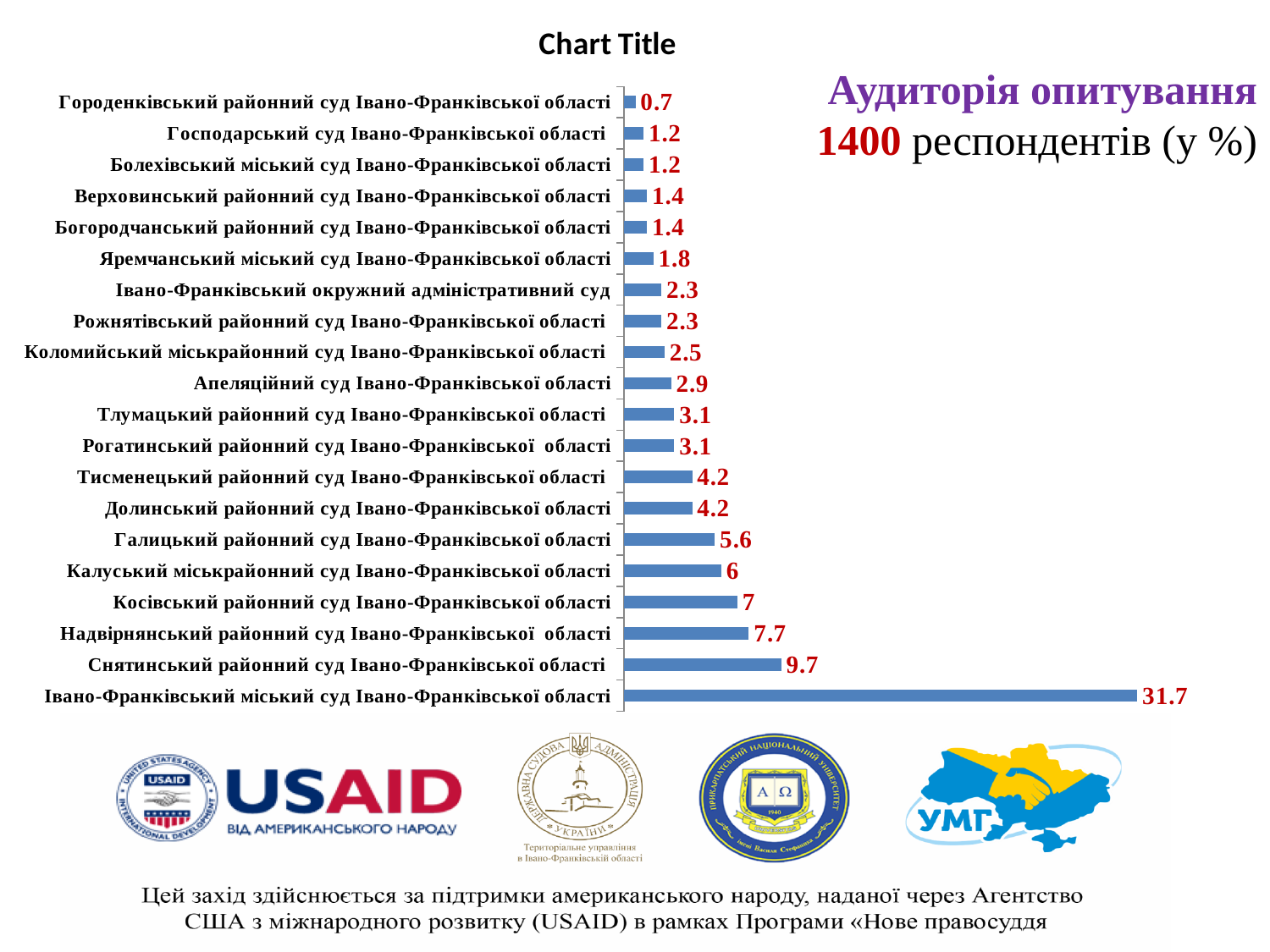
What type of chart is shown on the slide? Bar chart How many courts (categories) are shown in the chart? 20 What is the value for Яремчанський міський суд Івано-Франківської області? 1.8 Which court has the highest value in the chart? Івано-Франківський міський суд Івано-Франківської області What is the value for Апеляційний суд Івано-Франківської області? 2.9 What is the value for Снятинський районний суд Івано-Франківської області? 9.7 What is the difference between the values for Івано-Франківський міський суд Івано-Франківської області and Снятинський районний суд Івано-Франківської області? 22 What is the difference between the values for Надвірнянський районний суд and Галицький районний суд Івано-Франківської області? 2.1 Which court has the lowest value in the chart? Городенківський районний суд Івано-Франківської області What is the title shown above the chart? Chart Title Which has a larger value: Косівський районний суд or Калуський міськрайонний суд Івано-Франківської області? Косівський районний суд Івано-Франківської області What is the value for Калуський міськрайонний суд Івано-Франківської області? 6